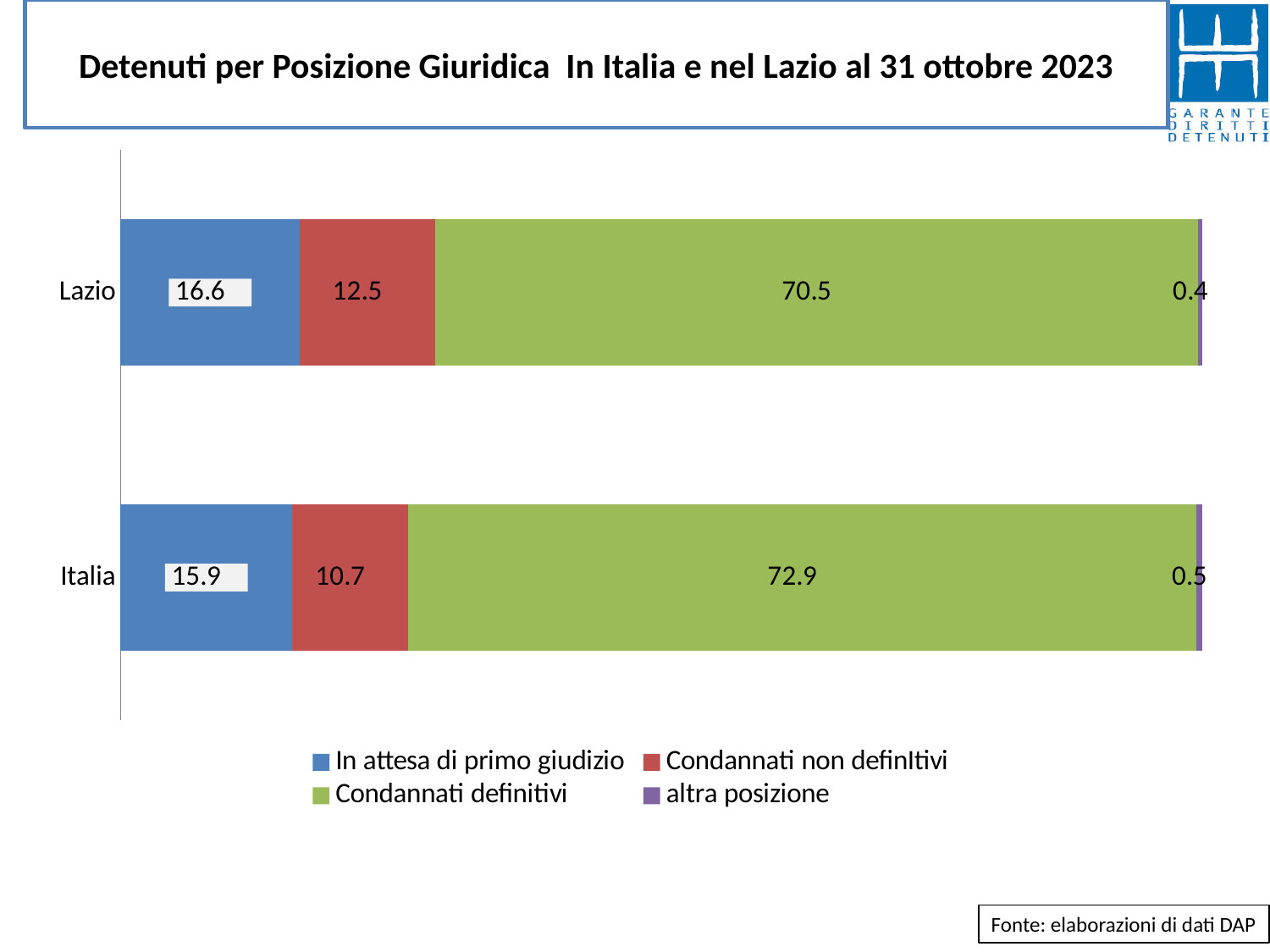
What is the value for 'altra posizione' in Italia? 0.5 Which is larger, the 'Condannati non definitivi' value for Lazio or for Italia? Lazio What is the value for 'In attesa di primo giudizio' in Italia? 15.9 What is the total of the Lazio stacked bar? 100.0 What is the value for 'Condannati definitivi' in Lazio? 70.5 What kind of chart is shown on the slide? Stacked bar chart How many series does the legend list? 4 What is the difference between the 'Condannati definitivi' values for Italia and Lazio? 2.4 How many categories are shown on the chart? 2 What is the value for 'Condannati non definitivi' in Lazio? 12.5 Which series has the largest value in the Italia bar? Condannati definitivi Which series has the smallest value in the Lazio bar? altra posizione